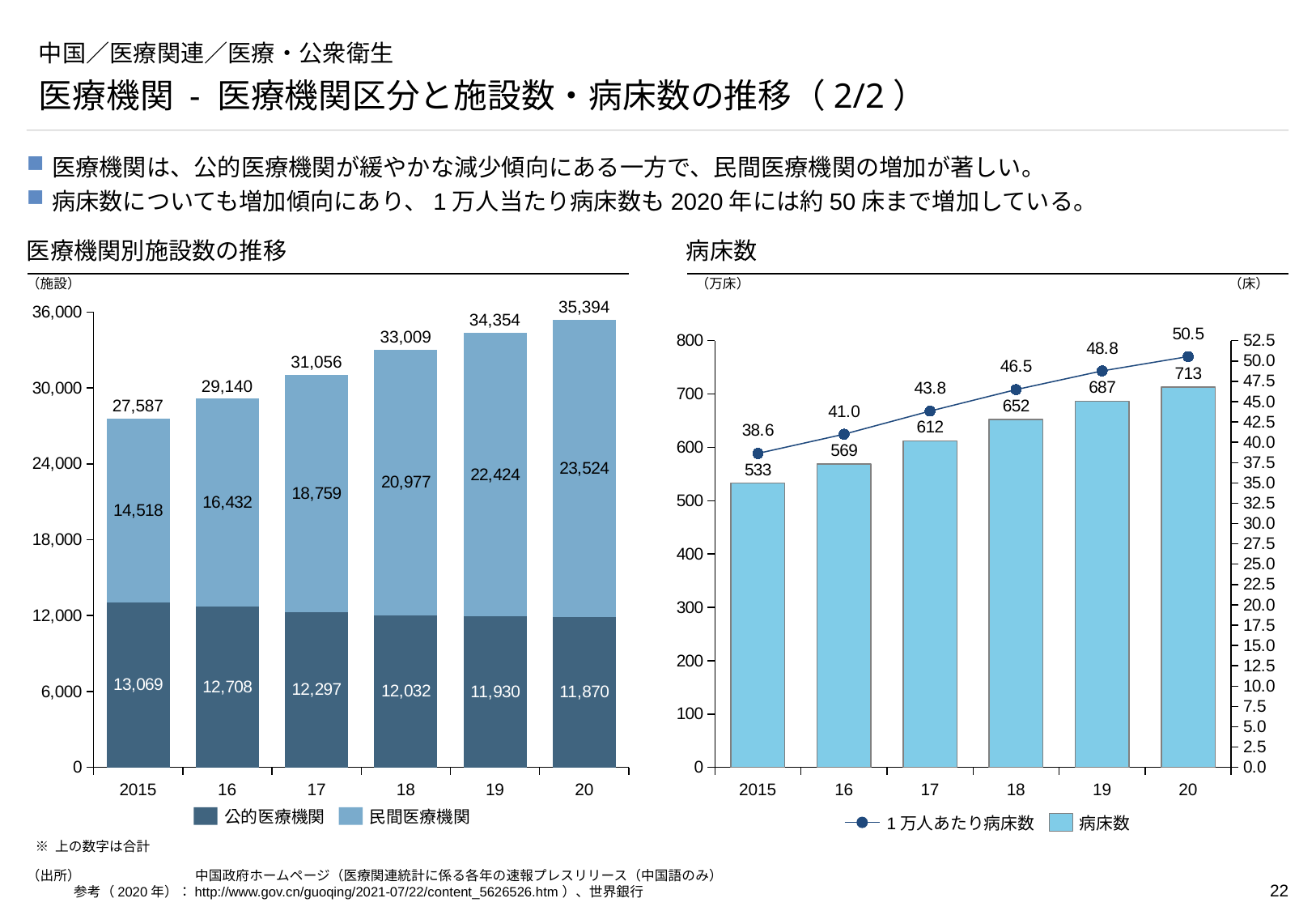
In the 医療機関別施設数の推移 chart, what is the value for 民間医療機関 in 20? 23,524 In the 病床数 chart, what is the difference between the 病床数 values for 20 and 2015? 180 In the 医療機関別施設数の推移 chart, how many series does the legend list? 2 In the 病床数 chart, what is the value for 1万人あたり病床数 in 2015? 38.6 In the 医療機関別施設数の推移 chart, does the value for 公的医療機関 rise or fall from 2015 to 20? fall In the 医療機関別施設数の推移 chart, what is the total of the stacked bar for 18? 33,009 In the 病床数 chart, how many years are shown on the x axis? 6 In the 医療機関別施設数の推移 chart, what is the difference between the 民間医療機関 values for 19 and 18? 1,447 In the 医療機関別施設数の推移 chart, what is the value for 公的医療機関 in 2015? 13,069 In the 病床数 chart, what is the value for 病床数 in 17? 612 In the 医療機関別施設数の推移 chart, which year has the lowest value for 公的医療機関? 20 In the 病床数 chart, which year has the highest value for 病床数? 20